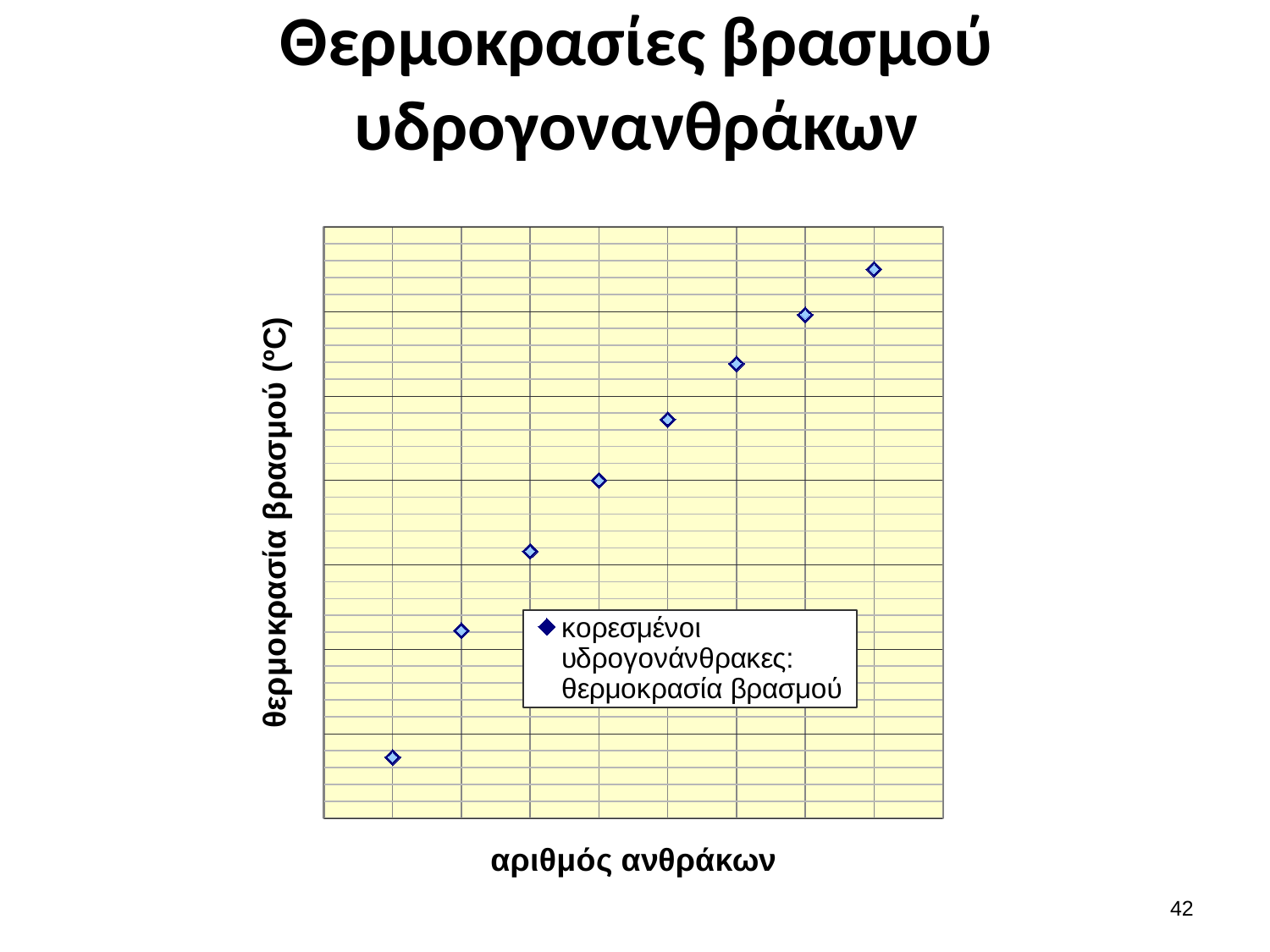
Which plotted point has the lowest boiling temperature, the leftmost or the rightmost? the leftmost What kind of chart is shown on the slide? scatter chart What is the title of the chart on the slide? Θερμοκρασίες βρασμού υδρογονανθράκων How many data points are plotted on the chart? 8 Do the plotted values rise or fall as the number of carbons increases along the x axis? rise What is the label of the x axis? αριθμός ανθράκων Is the boiling temperature of the second point from the left larger or smaller than that of the third point from the left? smaller Which plotted point has the highest boiling temperature, the leftmost or the rightmost? the rightmost How many series does the legend list? 1